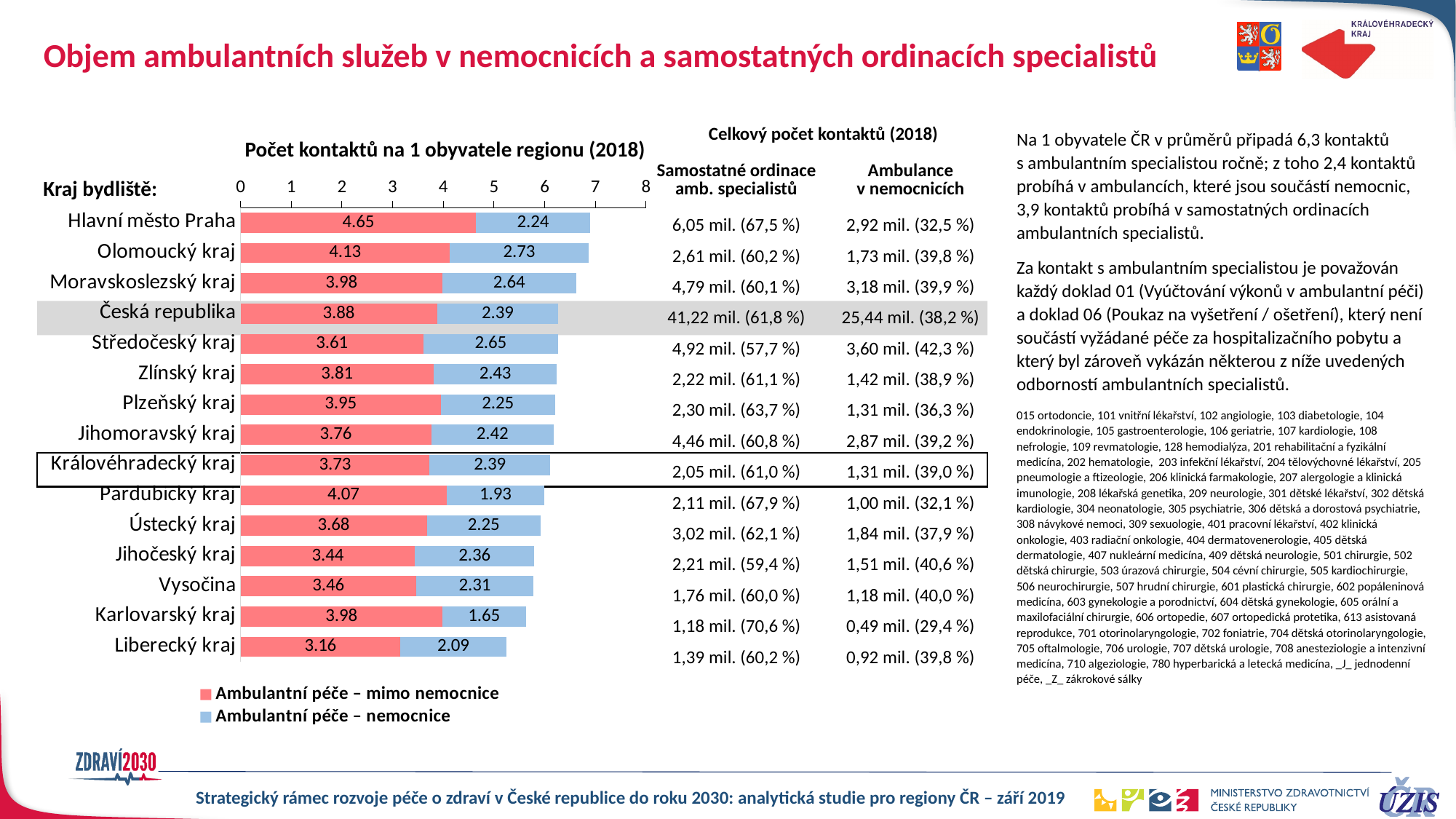
How many regions (categories) are plotted in the chart? 15 What is the title of the chart? Počet kontaktů na 1 obyvatele regionu (2018) What is the difference between the 'Ambulantní péče – mimo nemocnice' values for Olomoucký kraj and Jihočeský kraj? 0.69 What is the value of 'Ambulantní péče – mimo nemocnice' for Hlavní město Praha? 4.65 How many series does the chart legend list? 2 What is the value of 'Ambulantní péče – nemocnice' for Královéhradecký kraj? 2.39 Which region has the lowest value for 'Ambulantní péče – nemocnice'? Karlovarský kraj What is the total number of contacts per inhabitant for Liberecký kraj (sum of both series)? 5.25 Which region has the lowest value for 'Ambulantní péče – mimo nemocnice'? Liberecký kraj What type of chart is shown on the slide? Stacked bar chart Which is larger: the 'Ambulantní péče – nemocnice' value for Olomoucký kraj or for Pardubický kraj? Olomoucký kraj Which region has the highest value for 'Ambulantní péče – mimo nemocnice'? Hlavní město Praha